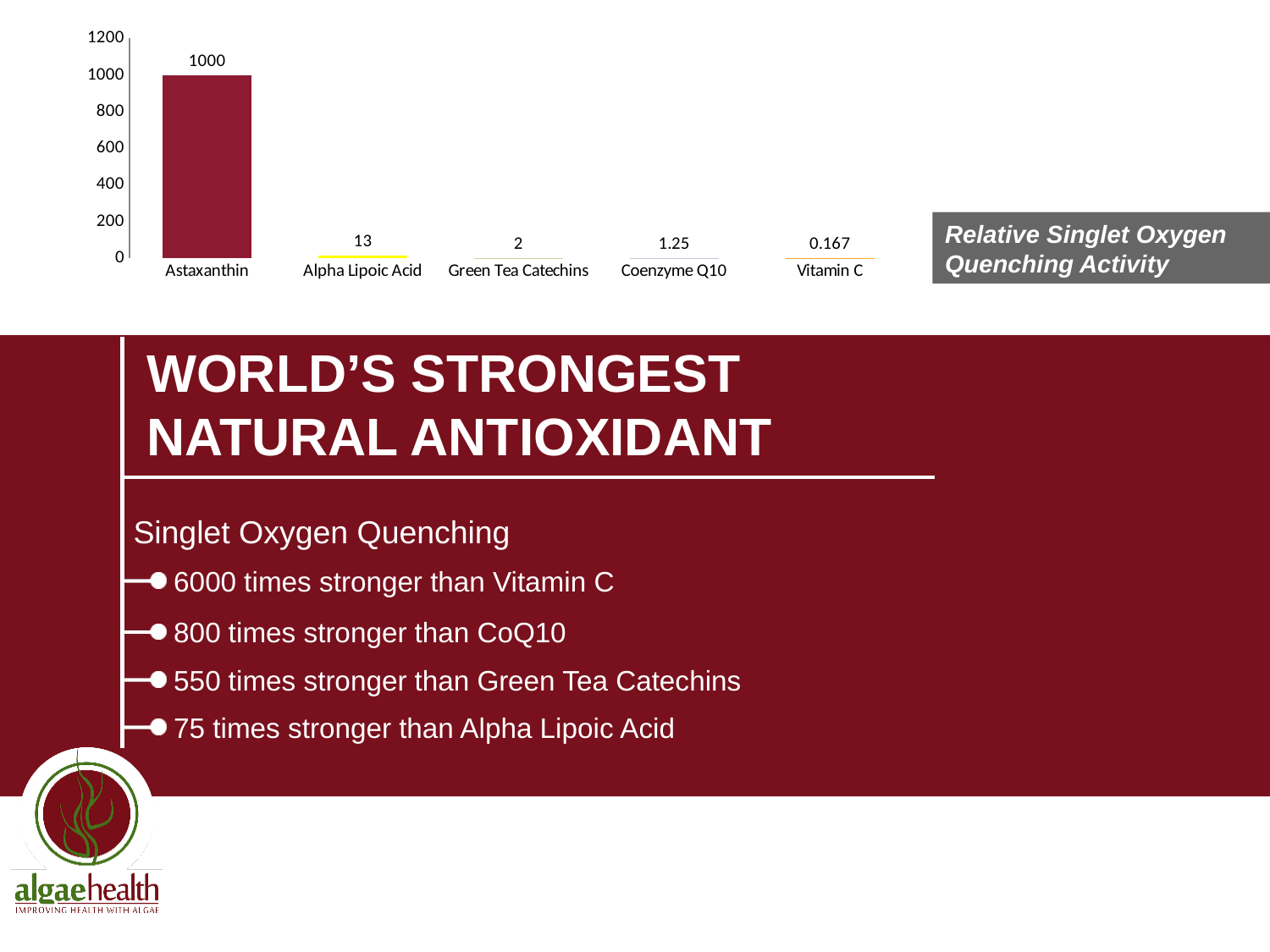
Do the values rise or fall from left to right along the x axis? Fall What is the value for Astaxanthin? 1000 Which category has the lowest value? Vitamin C What is the difference between the values for Astaxanthin and Alpha Lipoic Acid? 987 What is the value for Alpha Lipoic Acid? 13 What is the value for Green Tea Catechins? 2 Which category has the highest value? Astaxanthin What is the value for Coenzyme Q10? 1.25 Which is larger, the value for Green Tea Catechins or the value for Coenzyme Q10? Green Tea Catechins How many categories are shown on the chart? 5 What is the value for Vitamin C? 0.167 What kind of chart is shown on the slide? Bar chart